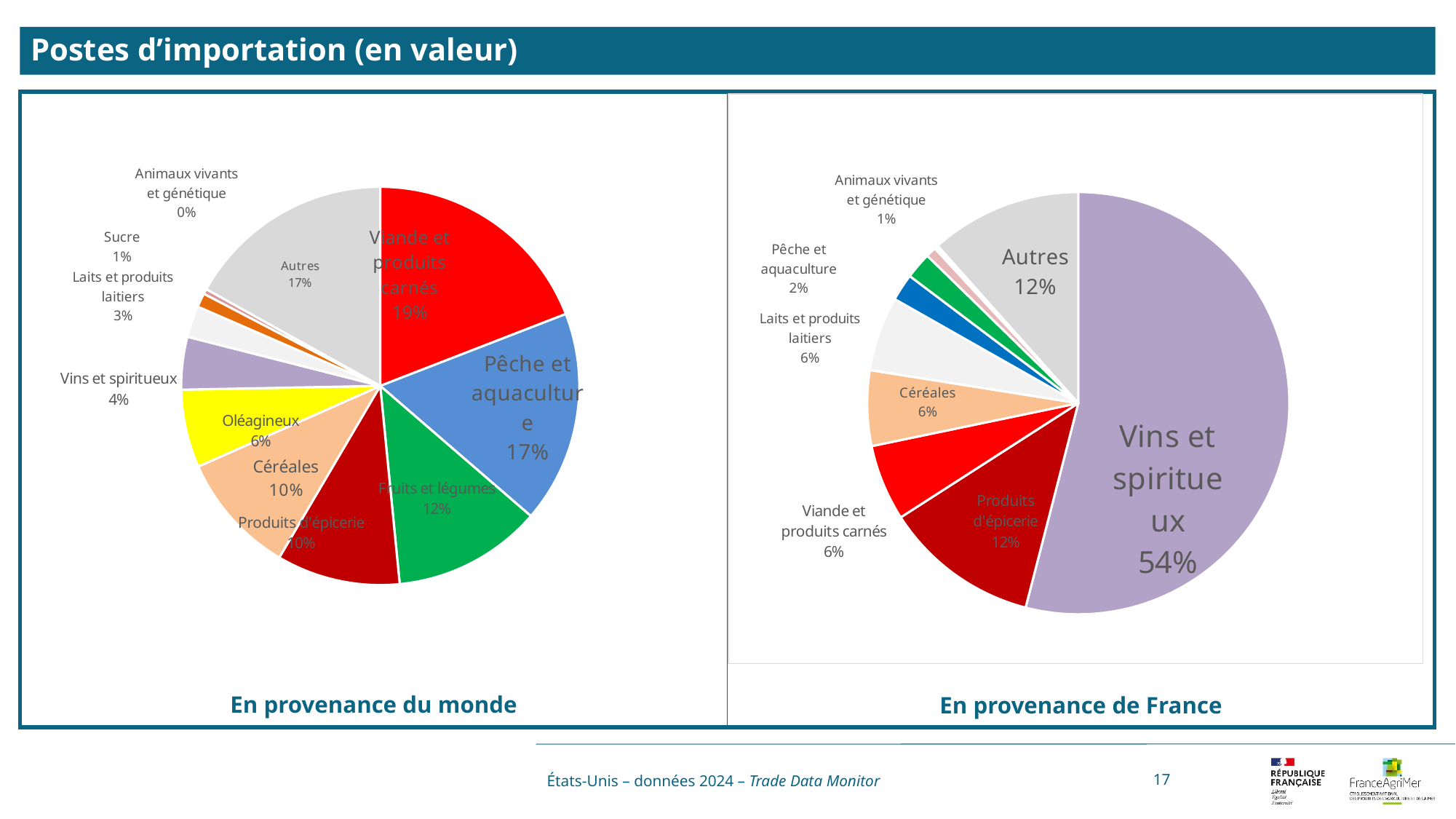
In the 'En provenance de France' pie chart, what share is Vins et spiritueux? 54% In the 'En provenance du monde' pie chart, what is the difference between the shares of Viande et produits carnés and Fruits et légumes? 7 percentage points In the 'En provenance du monde' pie chart, which is larger: Oléagineux or Vins et spiritueux? Oléagineux In the 'En provenance du monde' pie chart, what share is Viande et produits carnés? 19% In the 'En provenance du monde' pie chart, which category has the smallest share? Animaux vivants et génétique In the 'En provenance du monde' pie chart, which category has the largest share? Viande et produits carnés In the 'En provenance de France' pie chart, what share is Produits d'épicerie? 12% What is the title of the slide? Postes d'importation (en valeur) In the 'En provenance de France' pie chart, which category has the largest share? Vins et spiritueux What type of chart is used on this slide? Pie chart In the 'En provenance du monde' pie chart, what share is Pêche et aquaculture? 17% In the 'En provenance de France' pie chart, which is larger: Céréales or Produits d'épicerie? Produits d'épicerie